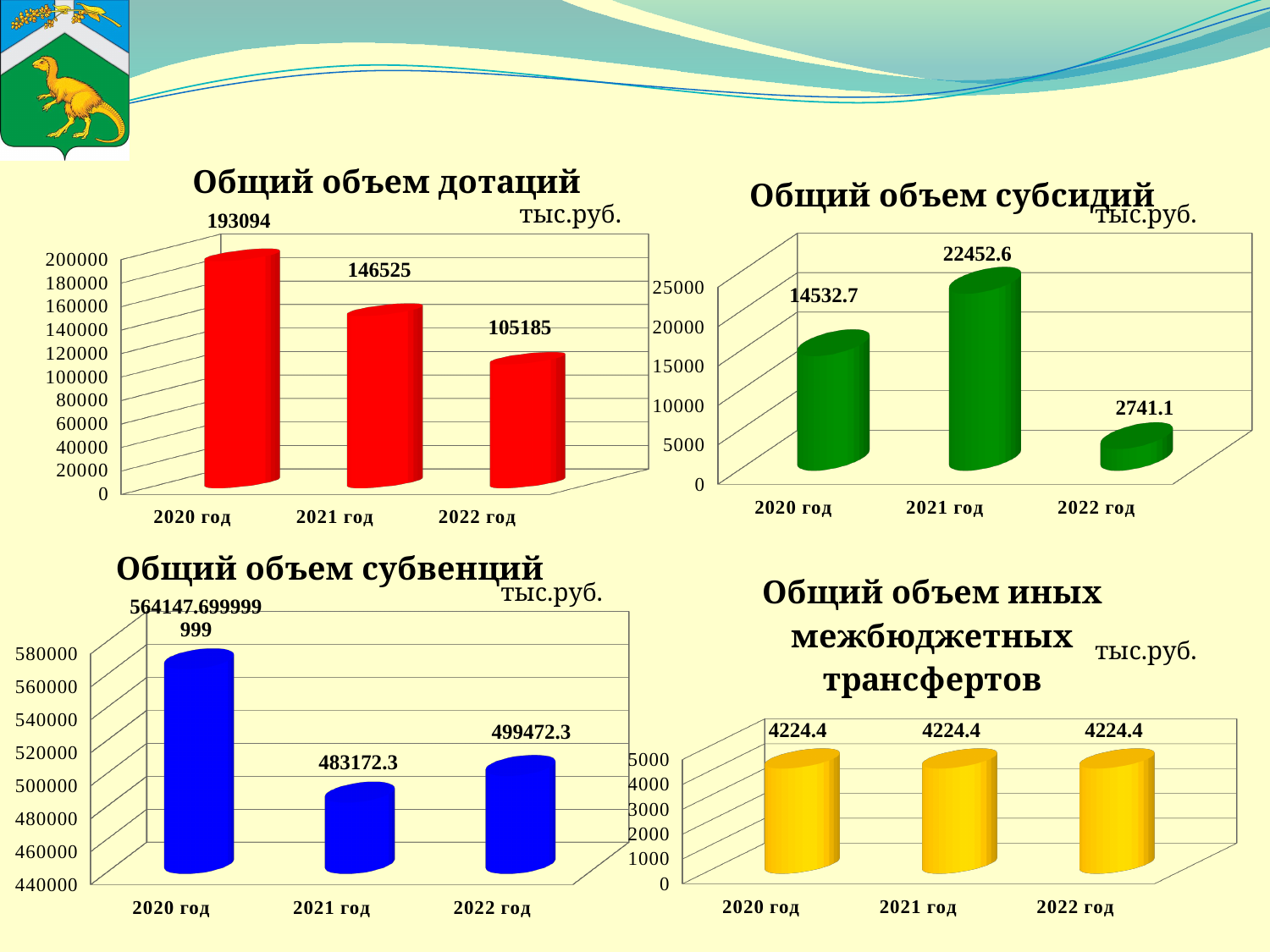
In the chart 'Общий объем субсидий', what is the difference between the values for 2021 год and 2022 год? 19711.5 In the chart 'Общий объем субсидий', what is the value for 2021 год? 22452.6 In the chart 'Общий объем дотаций', what is the difference between the values for 2020 год and 2021 год? 46569 How many categories are shown in the chart 'Общий объем иных межбюджетных трансфертов'? 3 In the chart 'Общий объем дотаций', what is the value for 2020 год? 193094 In the chart 'Общий объем дотаций', which year has the lowest value? 2022 год In the chart 'Общий объем иных межбюджетных трансфертов', what is the value for 2022 год? 4224.4 In the chart 'Общий объем субсидий', which year has the highest value? 2021 год In the chart 'Общий объем субвенций', which is larger, the value for 2021 год or 2022 год? 2022 год In the chart 'Общий объем субвенций', what is the value for 2021 год? 483172.3 In the chart 'Общий объем дотаций', do the values rise or fall from 2020 год to 2022 год? fall What kind of chart is 'Общий объем субвенций'? bar chart